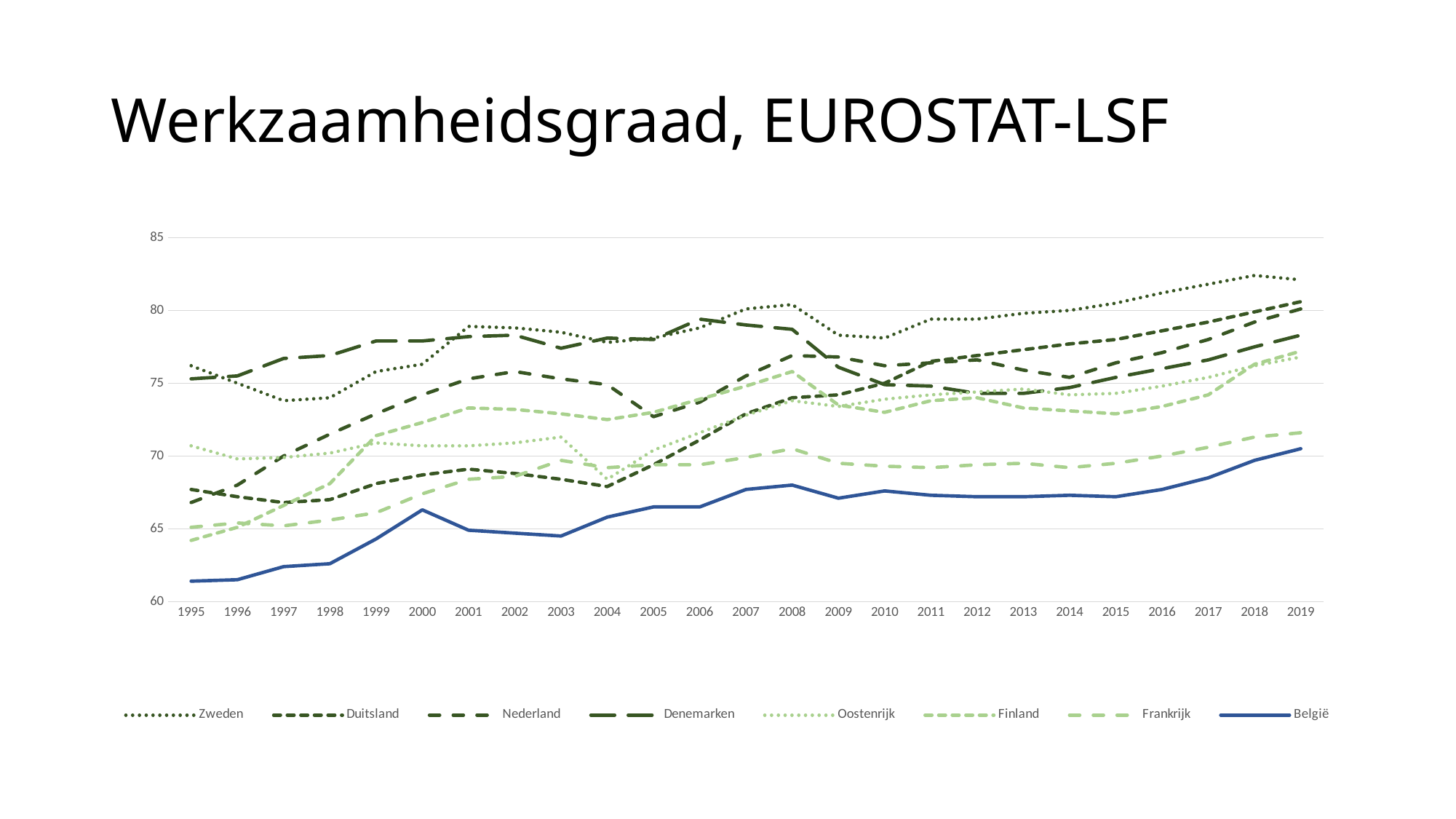
What is the title of the slide? Werkzaamheidsgraad, EUROSTAT-LSF Which country has the highest value in 2019? Zweden Which country has the lowest value in 1995? België How many years are shown along the x axis? 25 Does the value for België rise or fall overall from 1995 to 2019? rise How many series does the legend list? 8 Is the value for Zweden in 2019 greater or less than 80? greater Which is larger in 1995, the value for België or the value for Frankrijk? Frankrijk What kind of chart is shown on the slide? line chart Is the value for België in 1995 greater or less than 65? less Which series is drawn as a solid blue line? België Which country has the lowest value in 2019? België